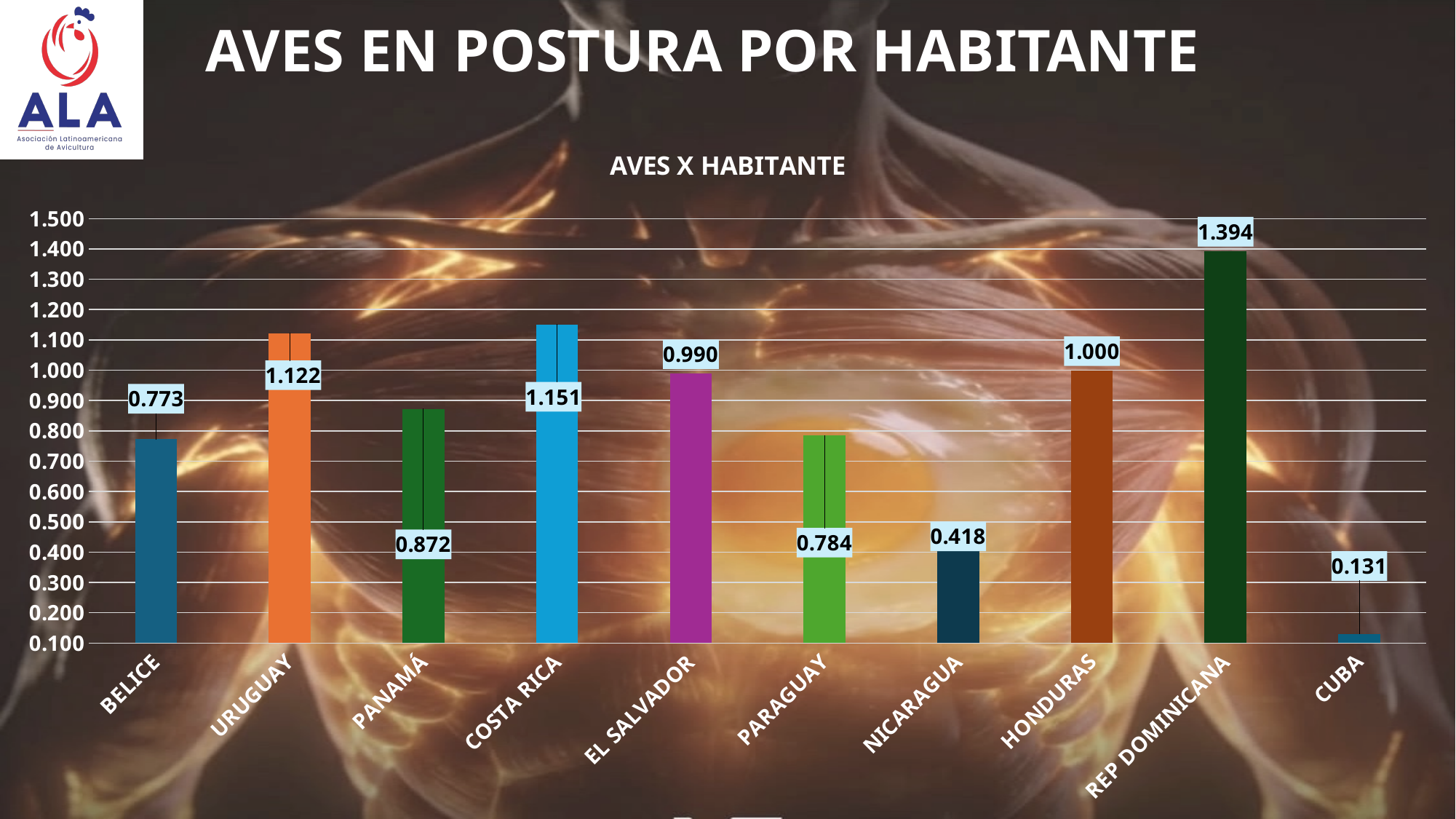
Which country has the highest value in the AVES X HABITANTE chart? REP DOMINICANA What is the value for COSTA RICA in the AVES X HABITANTE chart? 1.151 What is the value for REP DOMINICANA in the AVES X HABITANTE chart? 1.394 What is the title of the chart on the slide? AVES X HABITANTE What kind of chart is shown on the slide? bar chart Which has a larger value, URUGUAY or EL SALVADOR? URUGUAY Which country has the lowest value in the AVES X HABITANTE chart? CUBA Is the value for HONDURAS greater or less than 0.900? greater How many countries are shown in the AVES X HABITANTE chart? 10 What is the difference between the values for PANAMÁ and BELICE? 0.099 What is the difference between the values for REP DOMINICANA and CUBA? 1.263 What is the value for NICARAGUA in the AVES X HABITANTE chart? 0.418